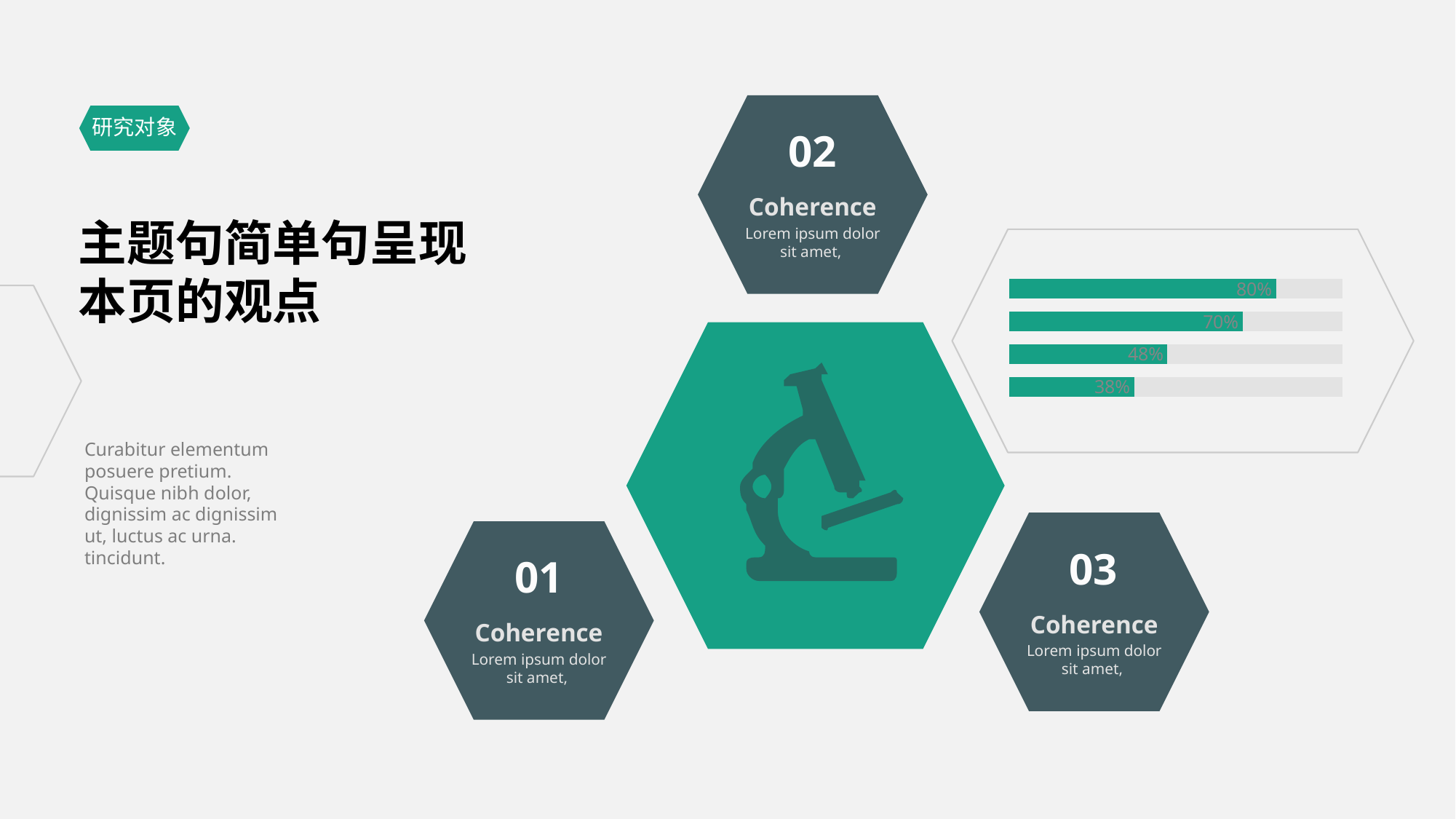
Which bar in the chart has the lowest value? the bottom bar (38%) What value is printed on the third bar from the top of the chart? 48% What value is printed on the second bar from the top of the chart? 70% Which bar in the chart has the highest value? the top bar (80%) How many bars does the chart on the right side of the slide have? 4 What value is printed on the bottom bar of the chart? 38% What kind of chart is shown on the right side of the slide? bar chart What value is printed on the top bar of the chart? 80% Do the bar values in the chart increase or decrease from top to bottom? decrease What is the difference between the second bar (70%) and the third bar (48%) in the chart? 22% Which is larger in the chart, the value of the second bar from the top or the value of the third bar from the top? the second bar from the top (70%) What is the difference between the top bar's value and the bottom bar's value in the chart? 42%